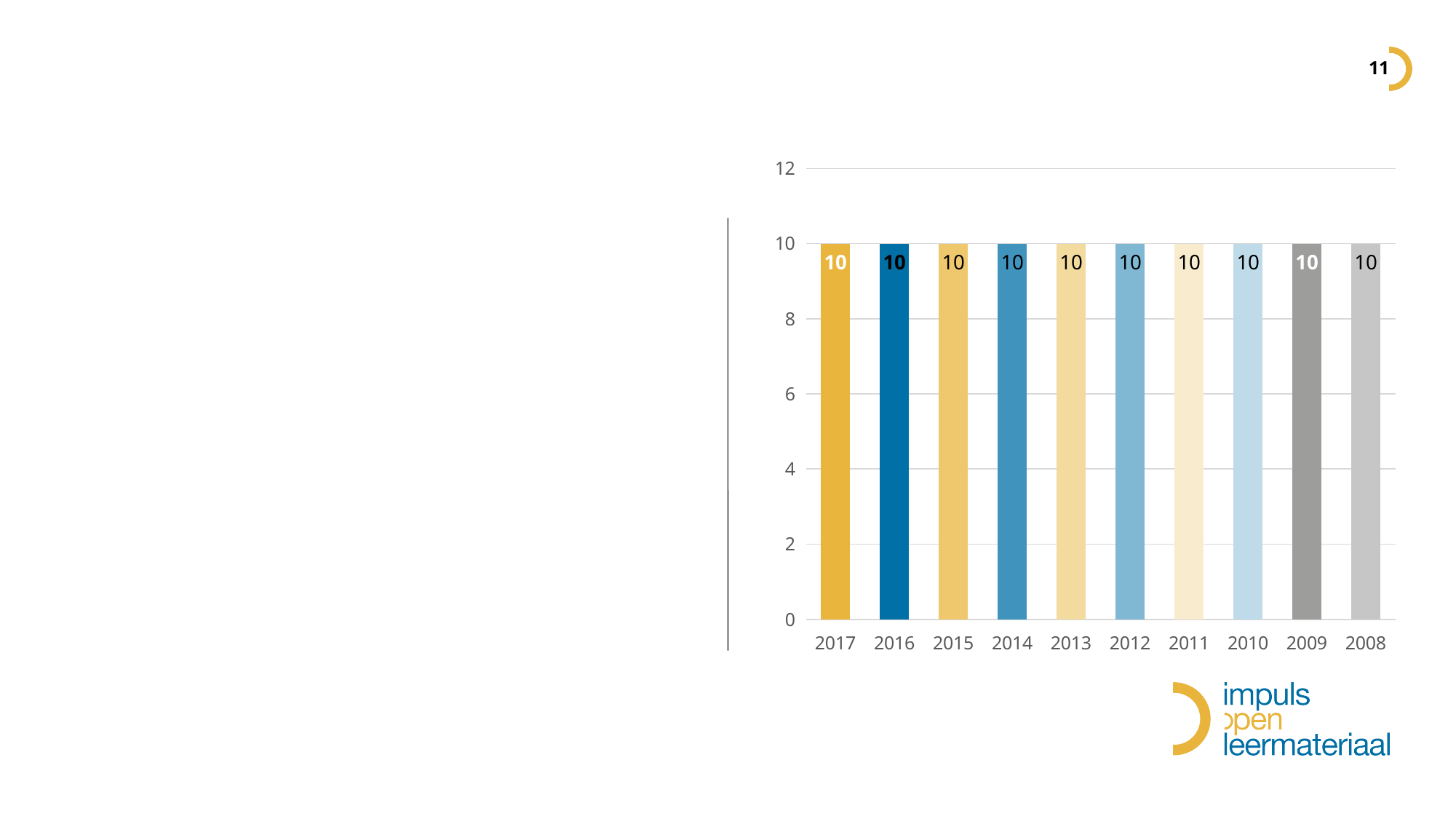
How many bars are shown in the chart? 10 Is the value for 2014 greater or less than 8? greater Which year is the leftmost category on the x axis? 2017 What is the value for 2017? 10 What is the highest value shown on the vertical axis? 12 Is the value for 2011 greater or less than 12? less What is the difference between the values for 2016 and 2009? 0 What is the value for 2008? 10 What kind of chart is shown on the slide? bar chart What is the value for 2010? 10 Do the values rise, fall or stay the same across the years on the x axis? stay the same What is the value for 2013? 10